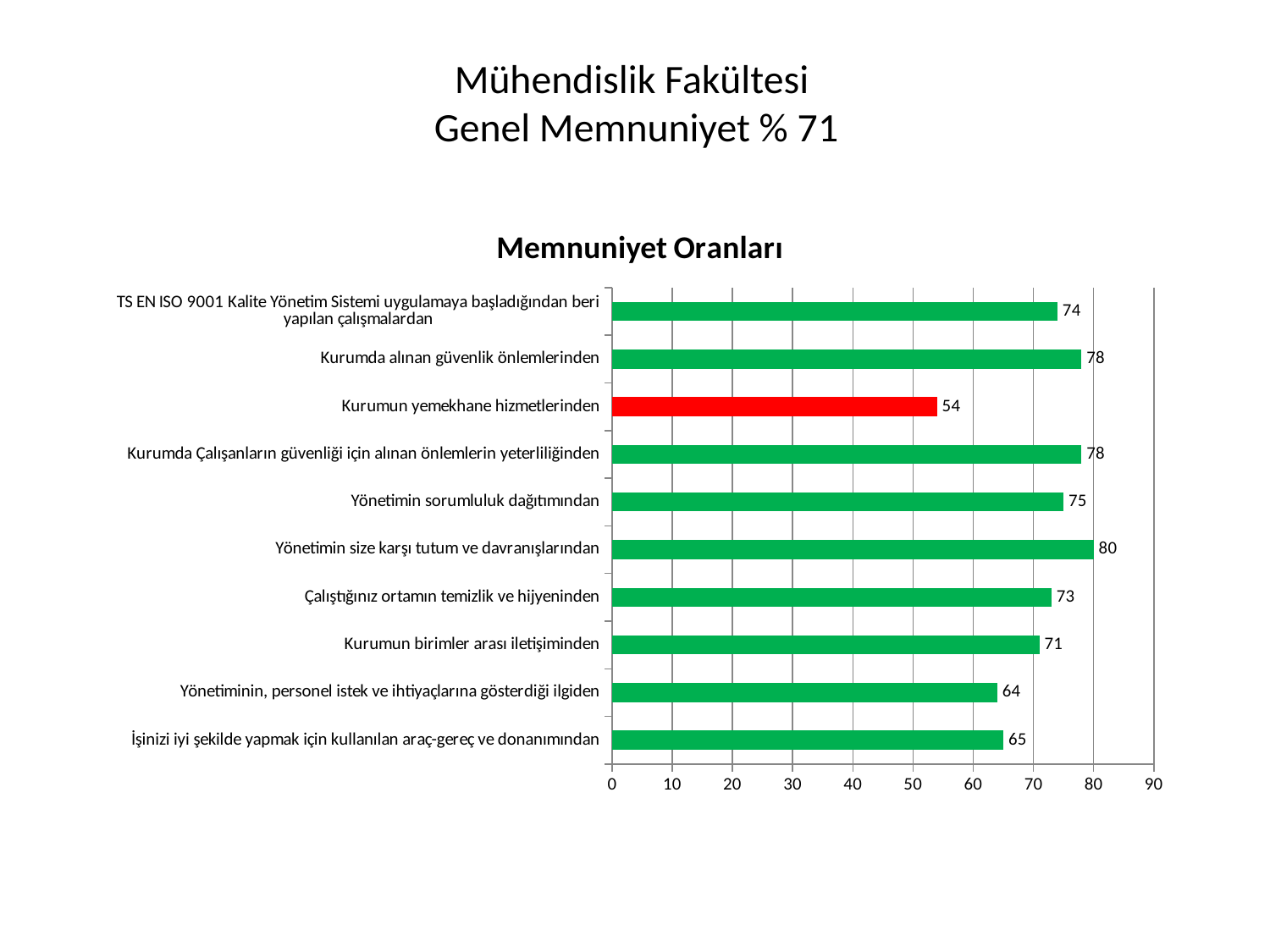
Which is larger: the value for "Çalıştığınız ortamın temizlik ve hijyeninden" or the value for "Yönetiminin, personel istek ve ihtiyaçlarına gösterdiği ilgiden"? Çalıştığınız ortamın temizlik ve hijyeninden What kind of chart is shown on the slide? bar chart Which category's bar is coloured red instead of green? Kurumun yemekhane hizmetlerinden Is the value for "Yönetimin sorumluluk dağıtımından" greater or less than 70? greater What is the value for "Yönetimin size karşı tutum ve davranışlarından"? 80 What is the difference between the values for "Kurumda alınan güvenlik önlemlerinden" and "Kurumun yemekhane hizmetlerinden"? 24 Which category has the lowest value? Kurumun yemekhane hizmetlerinden How many categories are shown in the chart? 10 What is the title of the chart? Memnuniyet Oranları What is the value for "Kurumun yemekhane hizmetlerinden"? 54 Which category has the highest value? Yönetimin size karşı tutum ve davranışlarından What is the value for "Kurumun birimler arası iletişiminden"? 71